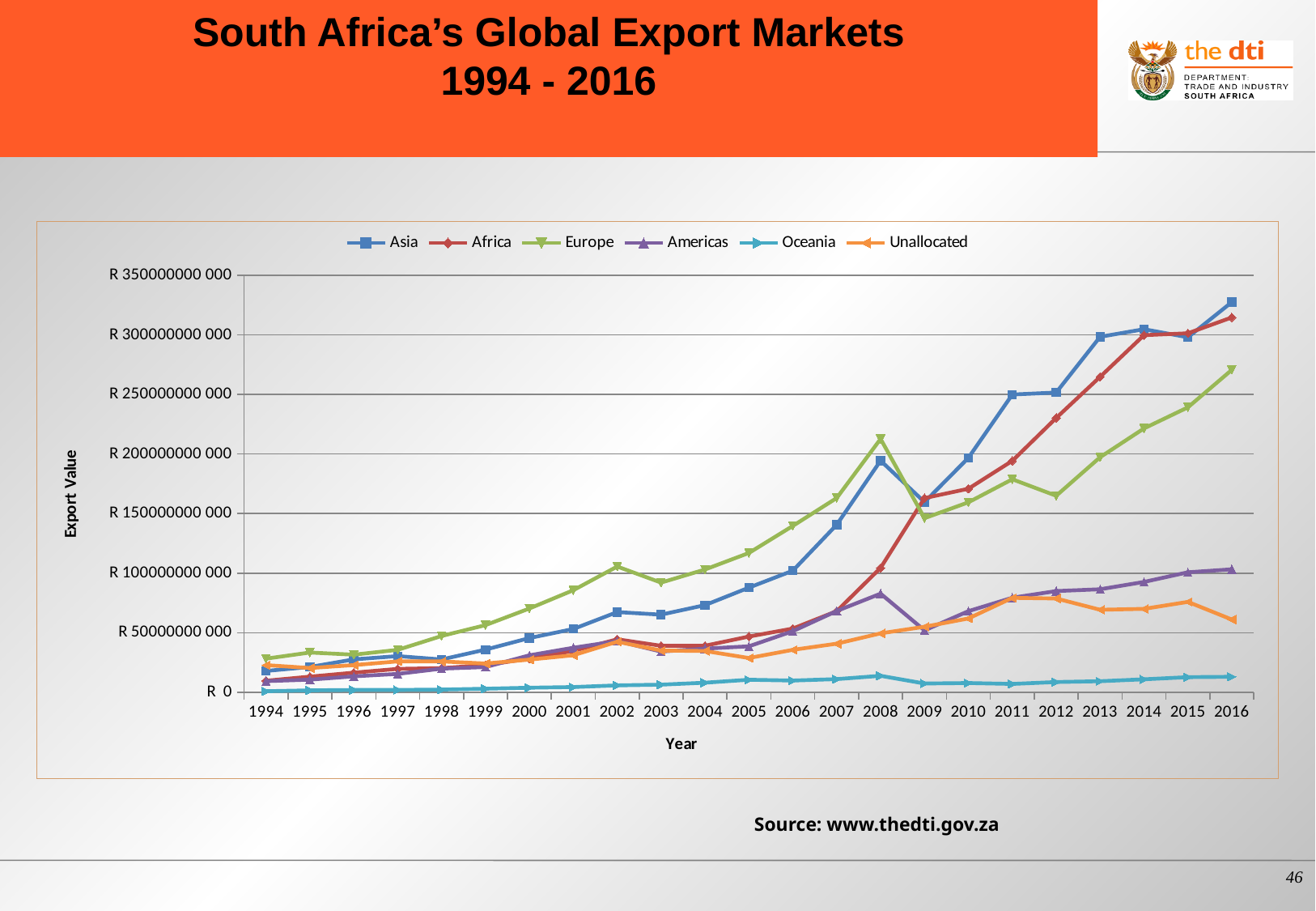
What is the label on the y axis of the chart? Export Value Is the value for Oceania in 2016 greater or less than R 50000000 000? less What kind of chart is shown on the slide? line chart Does the export value for Asia rise or fall overall from 1994 to 2016? rise Which series has the highest export value in 2016? Asia Which series has the highest export value in 1994? Europe Is the value for Asia in 2016 greater or less than R 300000000 000? greater Which series has the lowest export value in 2016? Oceania Is the value for Europe in 2008 greater or less than R 200000000 000? greater In 2002, which series has the larger export value, Europe or Asia? Europe How many years are plotted along the x axis? 23 How many series does the legend list? 6